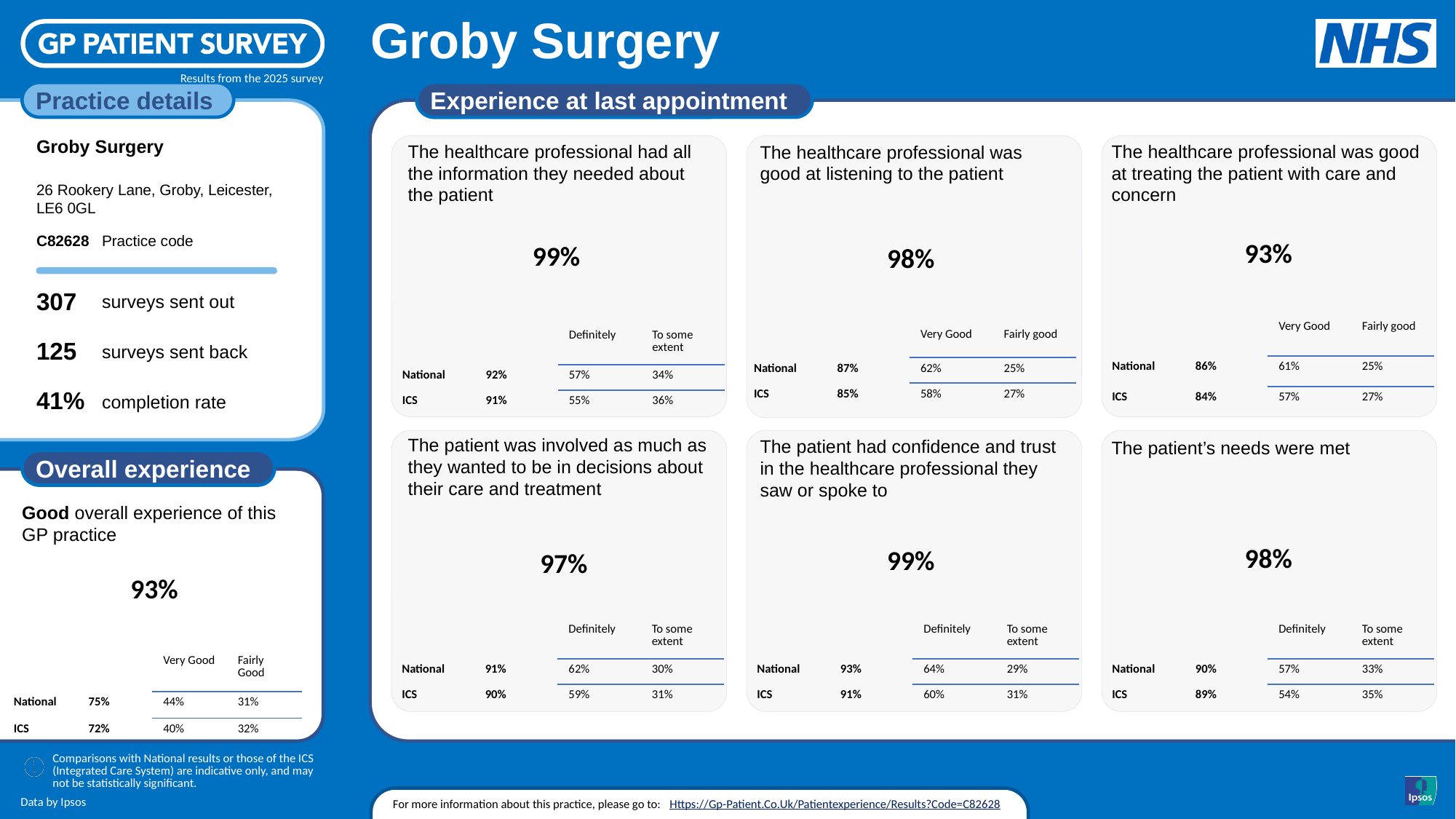
In the 'Overall experience' panel, what is the ICS 'Very Good' percentage? 40% In the panel 'The patient had confidence and trust in the healthcare professional they saw or spoke to', what is the National 'To some extent' percentage? 29% In the 'Overall experience' panel, what percentage of patients reported a good overall experience of this GP practice? 93% In the 'Experience at last appointment' section, which statement has the lowest practice percentage? The healthcare professional was good at treating the patient with care and concern In the panel 'The healthcare professional was good at treating the patient with care and concern', what is the difference between the practice figure and the ICS figure? 9 percentage points What is the title of the section containing the six statement panels on the right of the slide? Experience at last appointment In the panel 'The patient's needs were met', what is the difference between the practice figure and the National figure? 8 percentage points In the 'Experience at last appointment' section, what is the practice's figure for 'The healthcare professional was good at listening to the patient'? 98% In the 'Overall experience' panel, what is the National figure for good overall experience? 75% In the 'Experience at last appointment' section, how many statement panels are shown? 6 In the panel 'The healthcare professional had all the information they needed about the patient', which is higher: the National figure or the ICS figure? National In the panel 'The patient was involved as much as they wanted to be in decisions about their care and treatment', what is the ICS 'Definitely' percentage? 59%